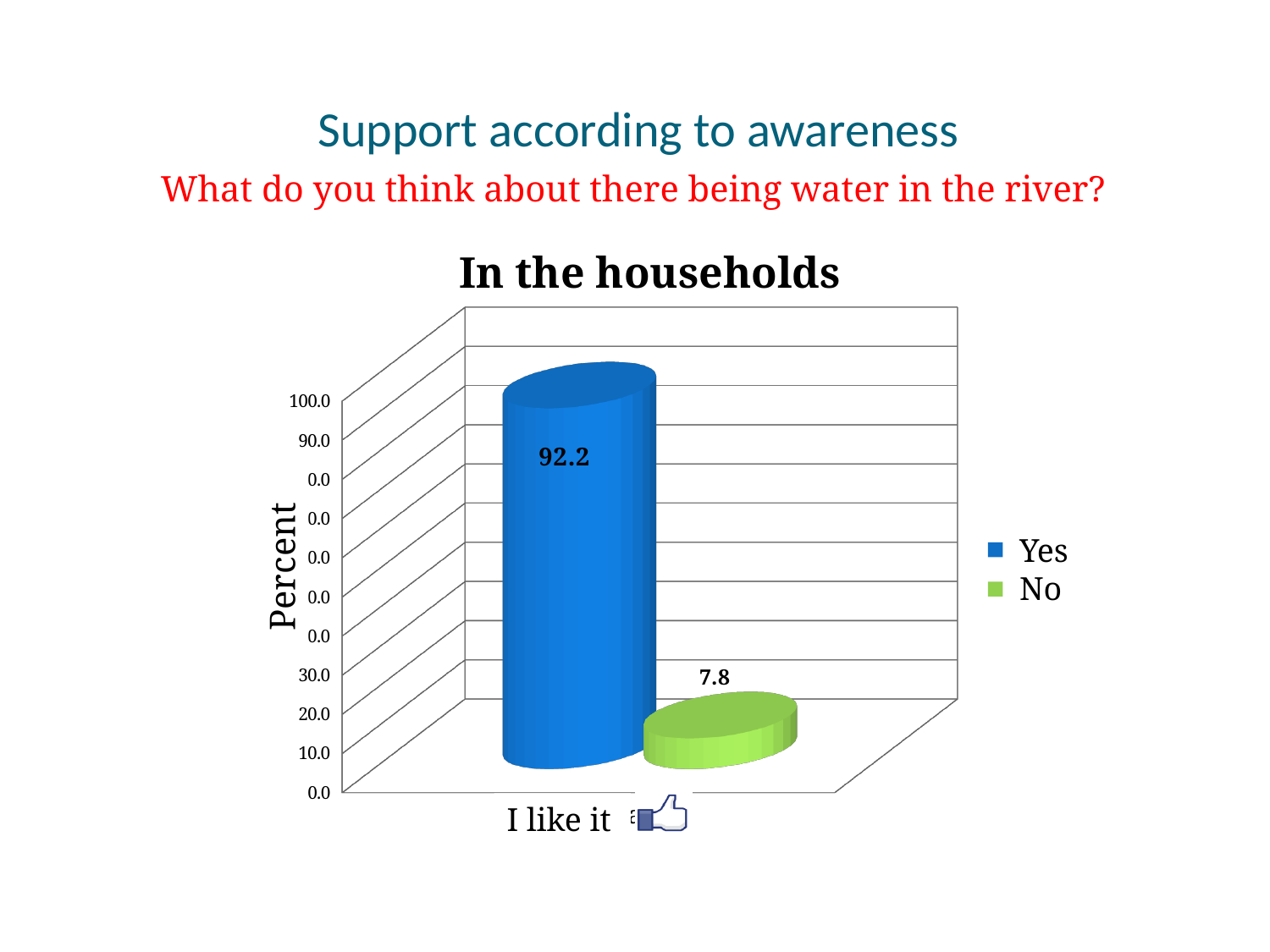
Which series has the highest value, Yes or No? Yes What is the value for Yes in the chart? 92.2 What kind of chart is shown on the slide? bar chart What is the value for No in the chart? 7.8 Is the value for No greater or less than 10.0? less What is the title of the chart? In the households How many series does the legend list? 2 Which series has the lowest value? No What is the difference between the Yes value and the No value? 84.4 Is the value for Yes larger or smaller than the value for No? larger What is the label on the vertical axis of the chart? Percent Is the value for Yes greater or less than 90.0? greater